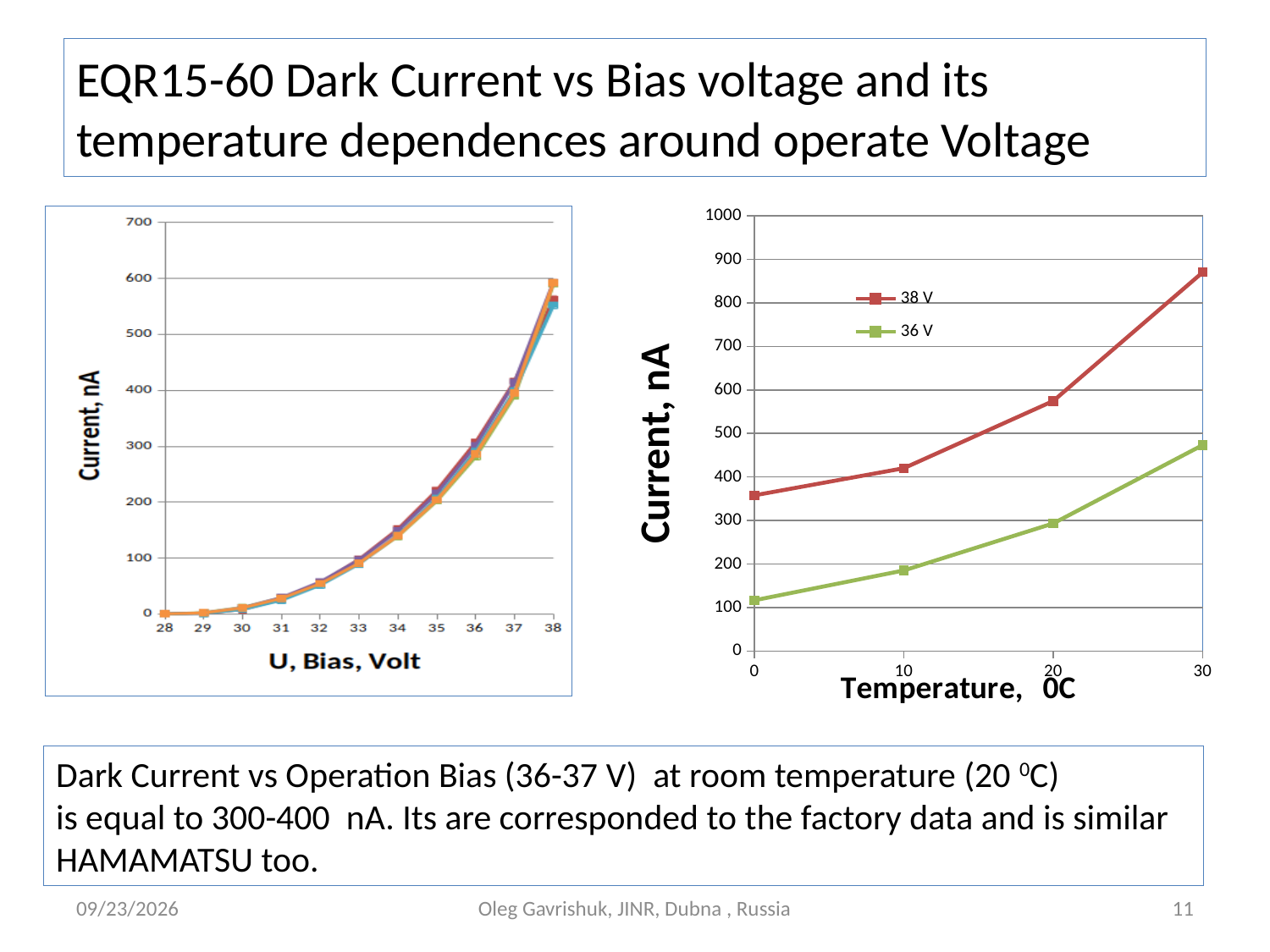
What are the two series named in the legend of the right-hand chart? 38 V and 36 V In the left-hand chart, do the current values rise or fall as the bias voltage increases from 28 V to 38 V? rise What is the x-axis label of the left-hand chart? U, Bias, Volt What type of chart is the right-hand chart (Current vs Temperature)? line chart In the right-hand chart, is the value of the 36 V series at 0 °C greater or less than 200? less In the right-hand chart, how many temperature points are plotted for each series? 4 In the right-hand chart, which series has the higher value at 20 °C, 38 V or 36 V? 38 V In the right-hand chart, is the value of the 36 V series at 30 °C greater or less than 400? greater In the right-hand chart, is the value of the 38 V series at 20 °C greater or less than 500? greater How many series does the legend of the right-hand chart list? 2 In the right-hand chart, do the values of the 38 V series rise or fall as temperature increases? rise